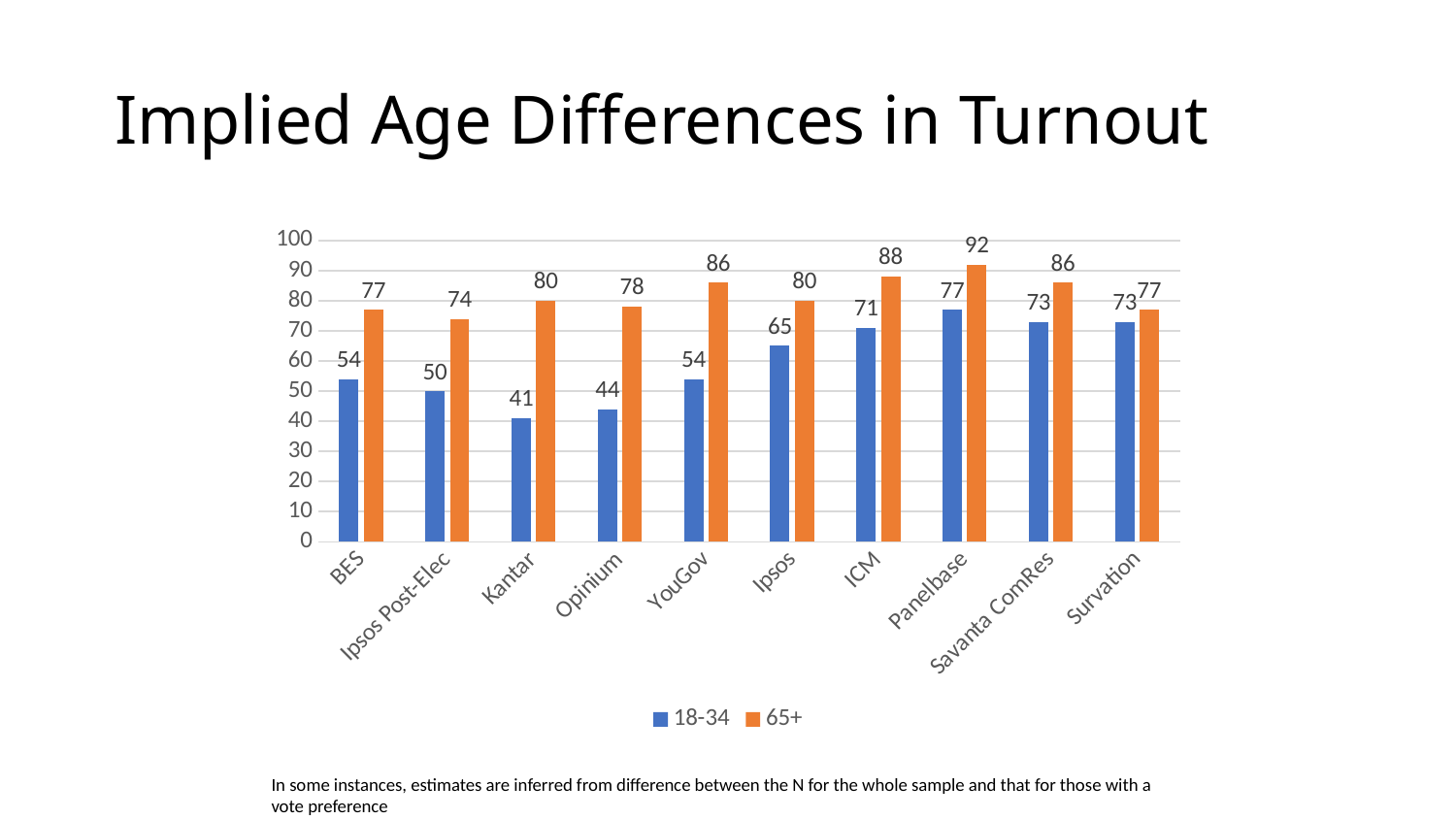
What is the 65+ value for Panelbase? 92 What is the title of the slide? Implied Age Differences in Turnout What is the 18-34 value for Kantar? 41 Which pollster has the lowest 18-34 value? Kantar Which pollster has the highest 65+ value? Panelbase What kind of chart is shown on the slide? bar chart What is the 65+ value for Ipsos Post-Elec? 74 Is the 18-34 value for YouGov greater or less than 60? less How many series does the legend list? 2 How many pollsters are shown on the x axis? 10 Which is larger, the 18-34 value for ICM or the 18-34 value for Ipsos? ICM What is the difference between the 65+ and 18-34 values for Opinium? 34